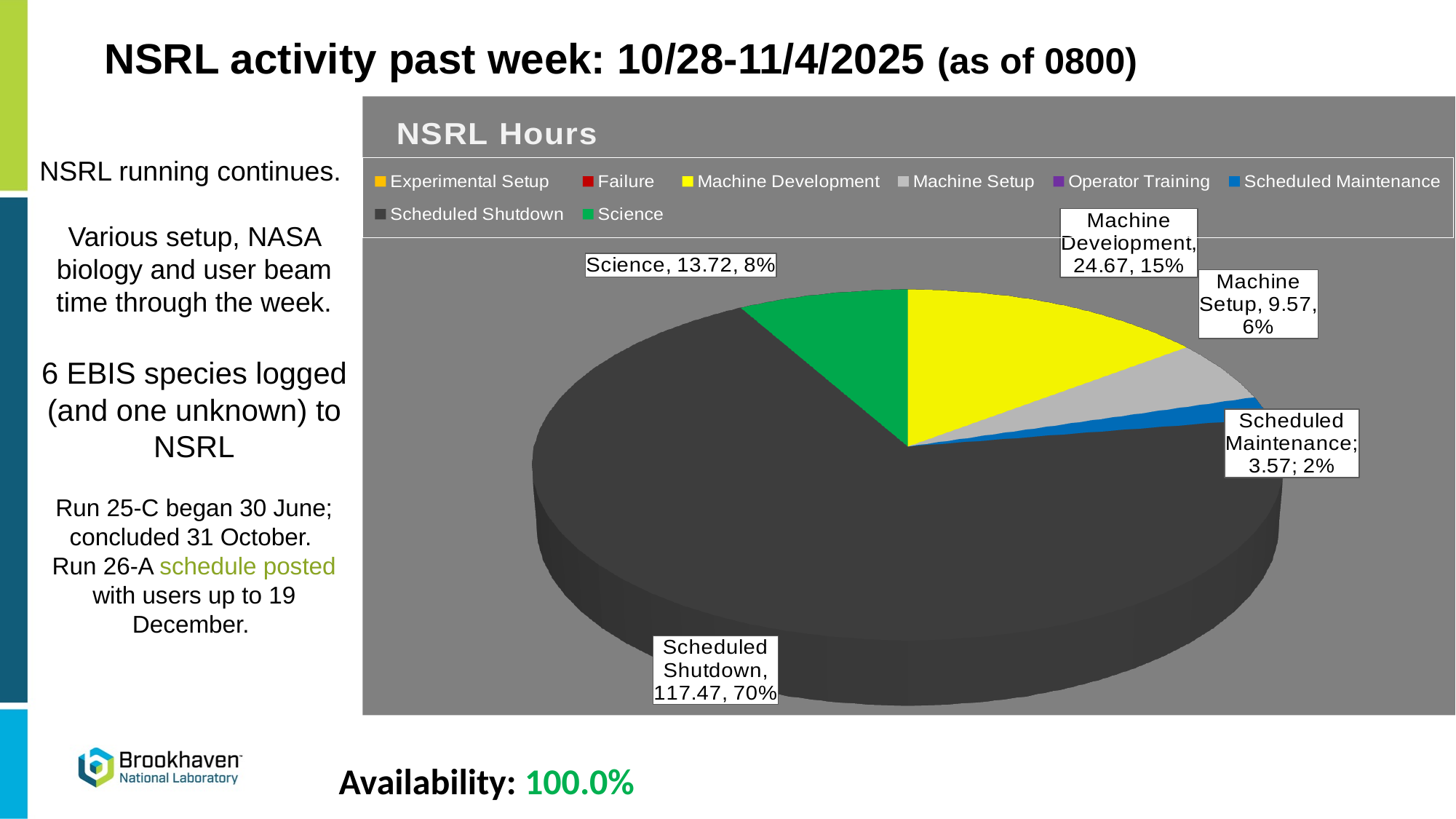
What share of the pie does Scheduled Shutdown represent? 70% How many hours are labelled for Science? 13.72 What kind of chart is shown on the slide? pie chart How many hours are labelled for Scheduled Maintenance? 3.57 Which labelled category has the smallest slice of the pie? Scheduled Maintenance How many hours are labelled for Scheduled Shutdown? 117.47 What share of the pie does Machine Setup represent? 6% What is the difference in hours between Machine Development and Science? 10.95 How many series does the chart's legend list? 8 What is the title of the chart? NSRL Hours Which labelled category has the largest slice of the pie? Scheduled Shutdown How many hours are labelled for Machine Development? 24.67